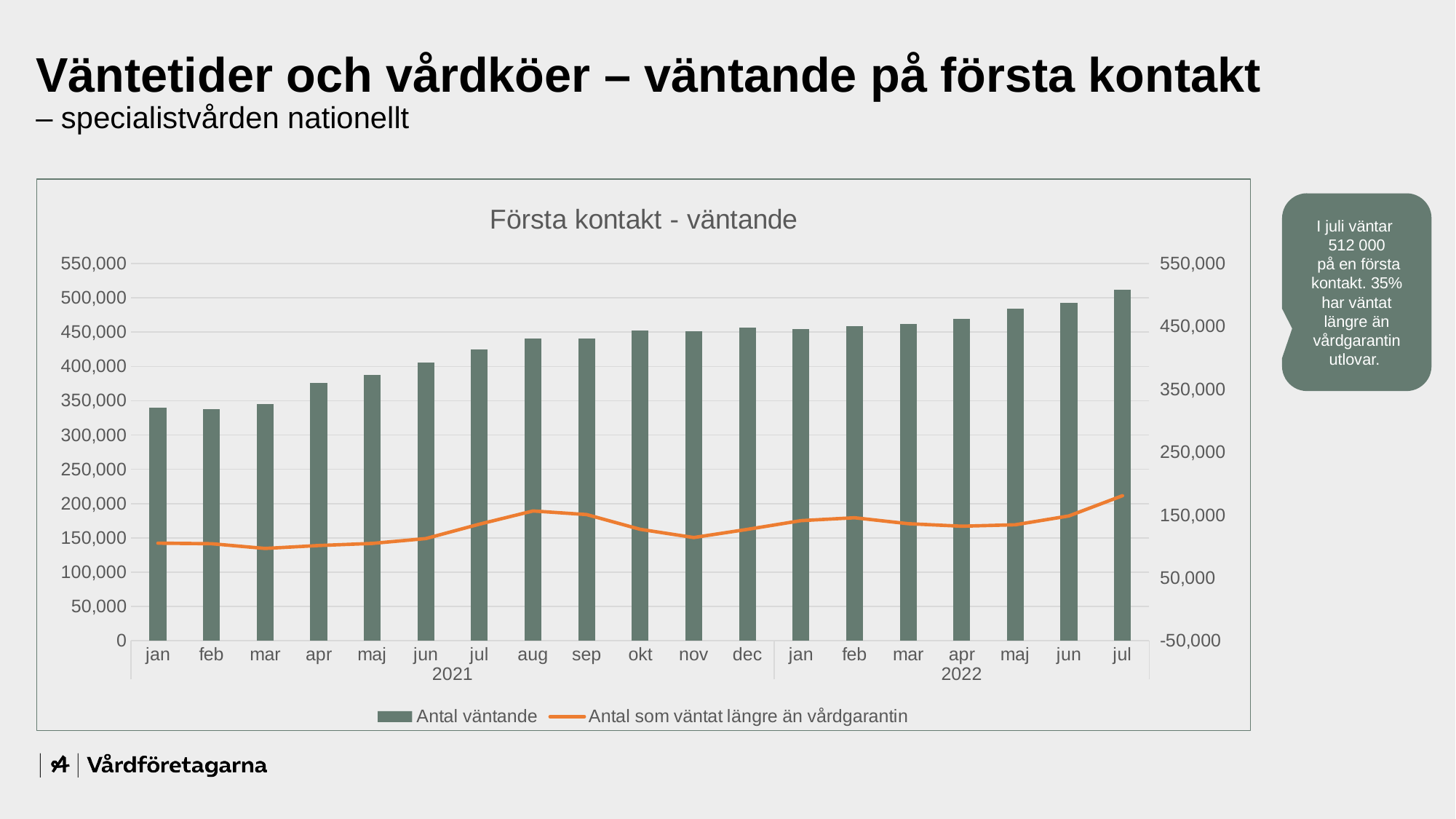
Do the Antal väntande bars generally rise or fall from jan 2021 to jul 2022? Rise How many series does the chart legend list? 2 Is the Antal väntande bar for jun 2021 greater or less than 450,000? less How many months are plotted along the x axis? 19 What kind of chart is shown? Bar chart combined with a line What is the title of the chart? Första kontakt - väntande Which month has the highest bar for Antal väntande? jul 2022 Is the Antal väntande bar for jan 2021 greater or less than 300,000? greater Which is larger, the Antal väntande bar for apr 2021 or for apr 2022? apr 2022 What are the two series named in the legend? Antal väntande; Antal som väntat längre än vårdgarantin According to the callout text, how many people were waiting for a first contact in July? 512 000 Is the Antal väntande bar for jul 2022 greater or less than 500,000? greater